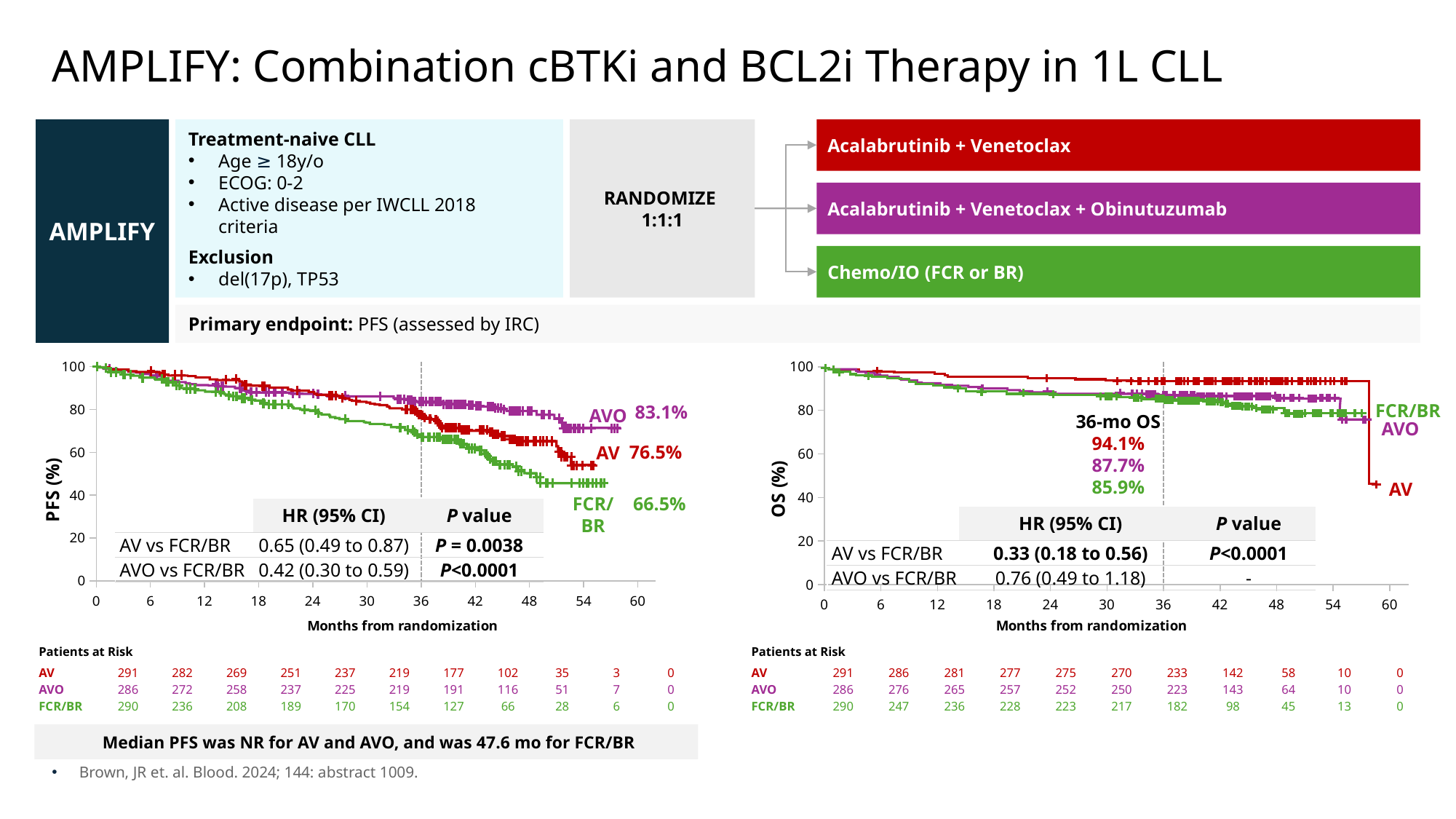
On the left PFS chart, what is the hazard ratio (95% CI) for AV vs FCR/BR? 0.65 (0.49 to 0.87) On the left PFS chart, is the FCR/BR curve at month 48 greater or less than 60%? less On the left PFS chart, how many AV patients were at risk at month 0? 291 On the left PFS chart, which arm has the lowest labelled PFS rate? FCR/BR On the left PFS chart, what is the 36-month PFS rate shown for AVO? 83.1% On the right OS chart, what is the 36-month OS rate shown in red for AV? 94.1% On the left PFS chart, what is the difference between the labelled PFS rates for AVO and AV? 6.6% On the right OS chart, what is the difference between the 36-month OS rates for AVO and FCR/BR? 1.8% What is the y-axis label of the right chart? OS (%) On the left PFS chart, what is the 36-month PFS rate shown for FCR/BR? 66.5% On the right OS chart, what is the P value for AV vs FCR/BR? P<0.0001 On the right OS chart, which arm has the highest 36-month OS rate? AV